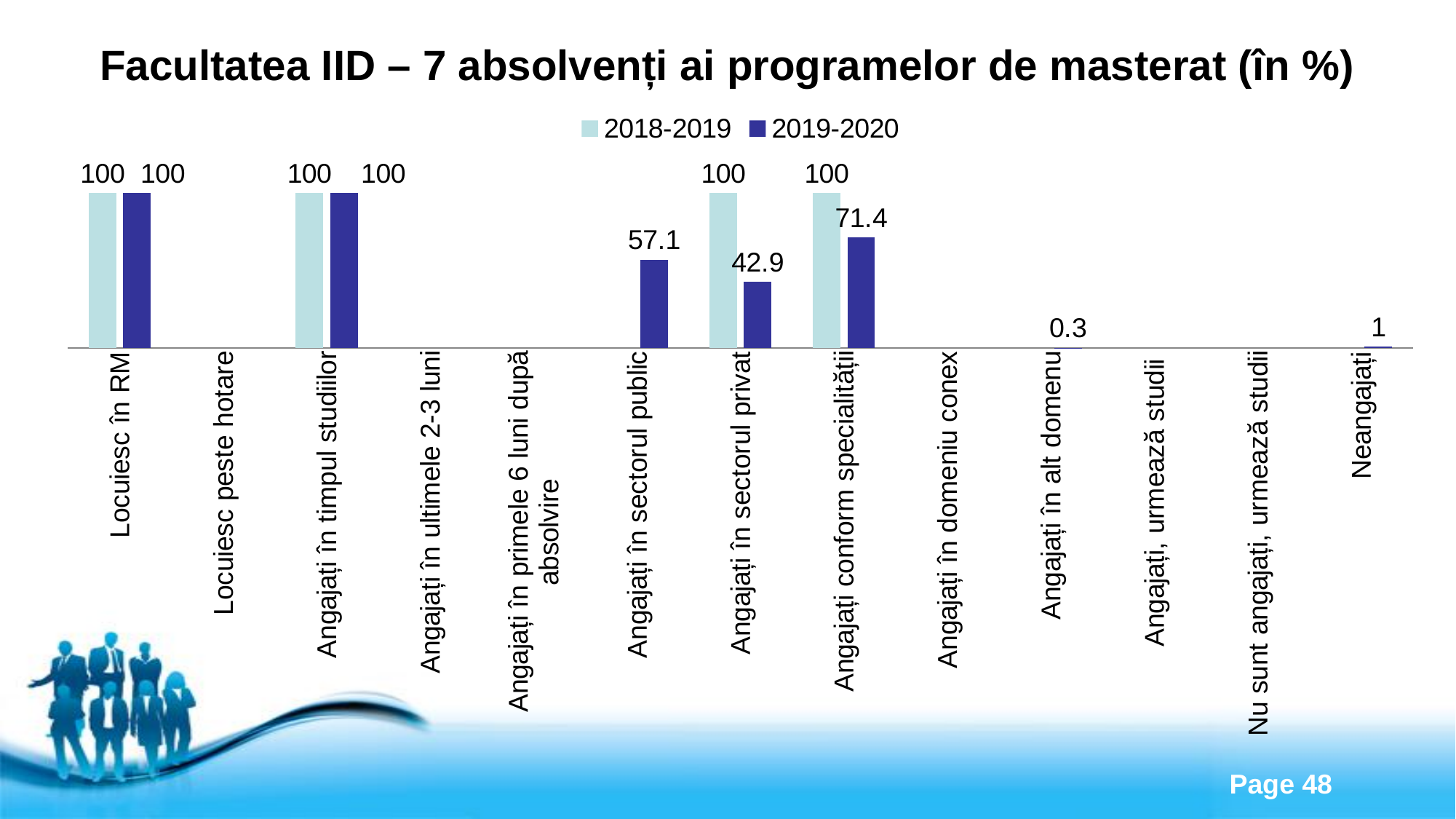
What are the two series named in the legend? 2018-2019 and 2019-2020 How many series does the legend list? 2 What is the 2019-2020 value for Angajați în sectorul privat? 42.9 For 2019-2020, which is larger: Angajați în sectorul public or Angajați în sectorul privat? Angajați în sectorul public What is the 2018-2019 value for Angajați conform specialității? 100 What is the 2018-2019 value for Locuiesc în RM? 100 What is the 2019-2020 value for Angajați în sectorul public? 57.1 What kind of chart is shown on the slide? Bar chart What is the difference between the 2019-2020 values for Angajați în sectorul public and Angajați în sectorul privat? 14.2 What is the difference between the 2018-2019 and 2019-2020 values for Angajați conform specialității? 28.6 Among Angajați în sectorul privat, Angajați în sectorul public and Angajați conform specialității, which has the lowest 2019-2020 value? Angajați în sectorul privat What is the 2019-2020 value for Angajați conform specialității? 71.4